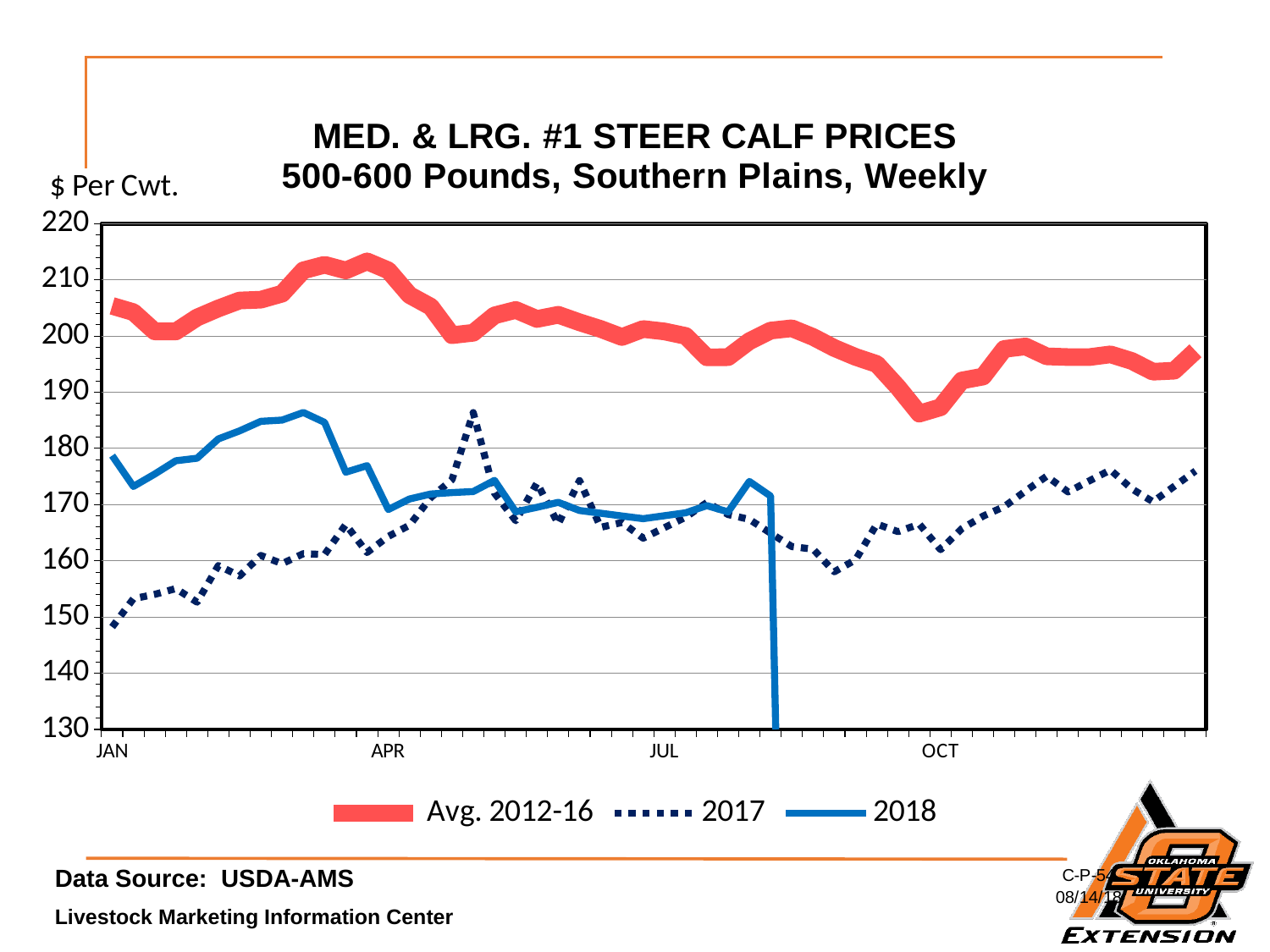
What kind of chart is shown on the slide? line chart How many series does the legend list? 3 Is the 2017 value at JUL greater or less than 170? less How many month labels are shown on the x-axis? 4 Which series has the lowest value in JAN? 2017 What unit is shown on the y-axis label? $ Per Cwt. Is the Avg. 2012-16 value in JAN greater or less than 200? greater Does the 2017 line generally rise or fall from JAN to APR? rise Is the 2017 value in JAN greater or less than 160? less Which series is plotted highest across the whole year? Avg. 2012-16 In JAN, which is higher, the 2018 line or the 2017 line? 2018 What is the title of the chart? MED. & LRG. #1 STEER CALF PRICES 500-600 Pounds, Southern Plains, Weekly